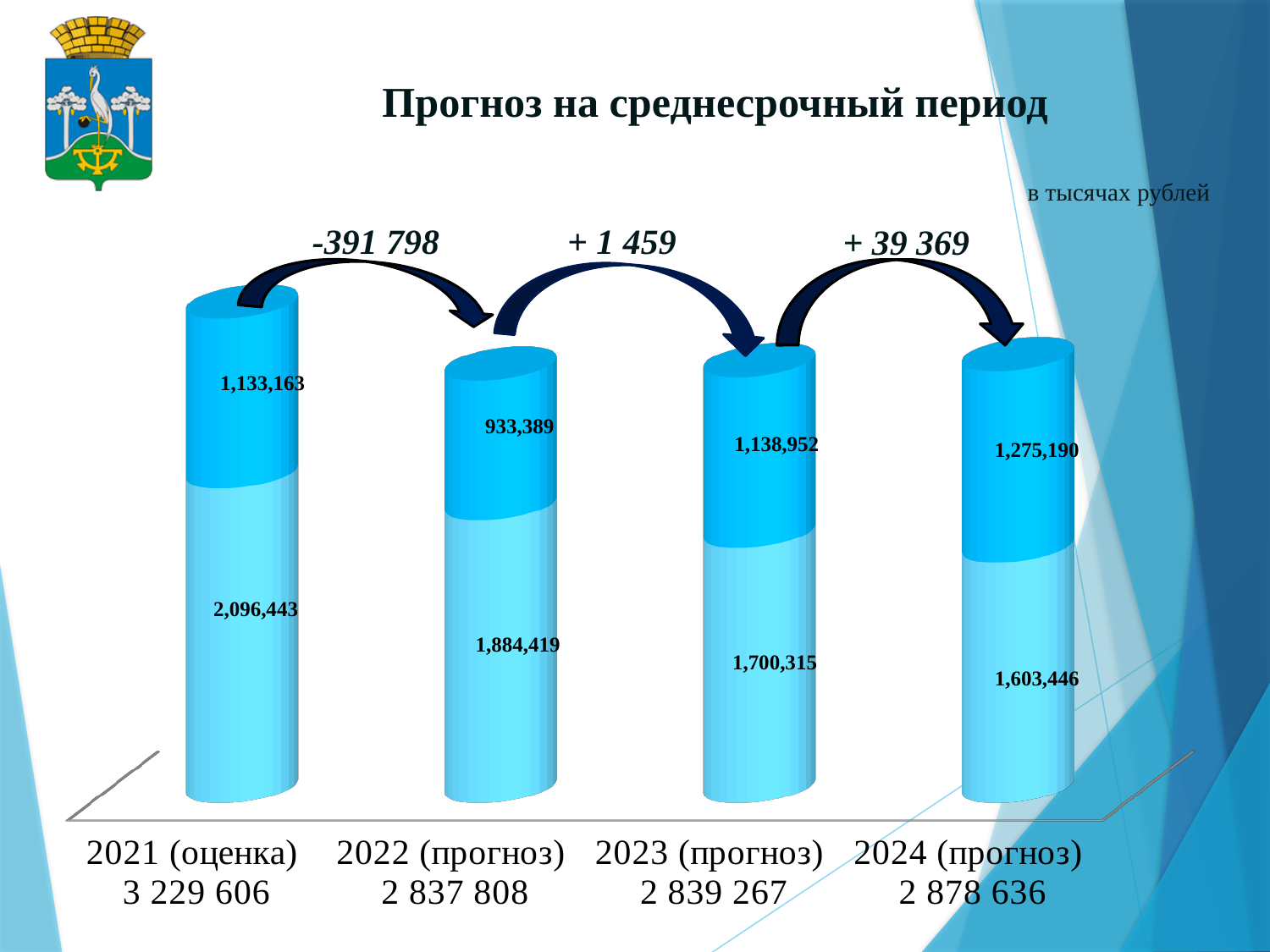
What is the total shown for the 2022 (прогноз) bar? 2 837 808 Which category has the highest total? 2021 (оценка) How many categories (years) are shown on the x axis? 4 Which category has the lowest value for the upper (darker) segment? 2022 (прогноз) What is the value of the upper (darker) segment of the bar for 2021 (оценка)? 1,133,163 Do the values of the lower (lighter) segment rise or fall from 2021 to 2024? fall What is the value of the lower (lighter) segment of the bar for 2024 (прогноз)? 1,603,446 What kind of chart is shown on the slide? bar chart What is the difference between the upper (darker) segment values for 2024 (прогноз) and 2023 (прогноз)? 136,238 For 2023 (прогноз), which segment is larger, the upper (darker) or the lower (lighter)? lower (lighter), 1,700,315 In what units are the values on the chart given, according to the slide? в тысячах рублей What change is shown by the arrow from 2021 (оценка) to 2022 (прогноз)? -391 798